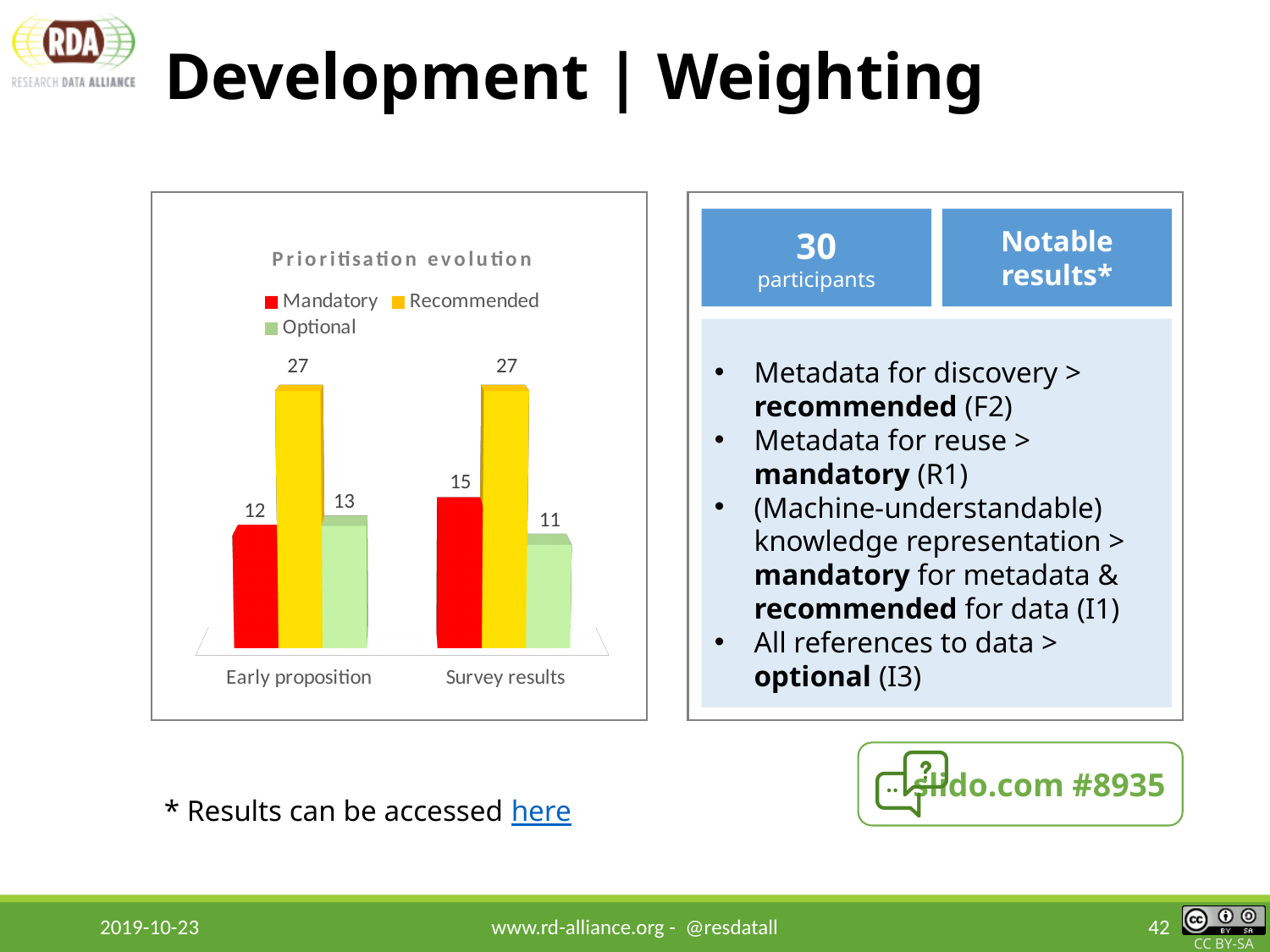
Which series has the highest value in the Early proposition category? Recommended What is the value for Mandatory in the Early proposition category? 12 How many categories are shown on the x axis of the chart? 2 What is the value for Optional in the Survey results category? 11 What kind of chart is shown on the slide? Bar chart Which series has the lowest value in the Survey results category? Optional What is the difference between the Mandatory values for Survey results and Early proposition? 3 What is the value for Mandatory in the Survey results category? 15 What is the title of the chart? Prioritisation evolution What is the value for Recommended in the Survey results category? 27 Which is larger: the Optional value for Early proposition or the Optional value for Survey results? Early proposition How many series does the chart legend list? 3